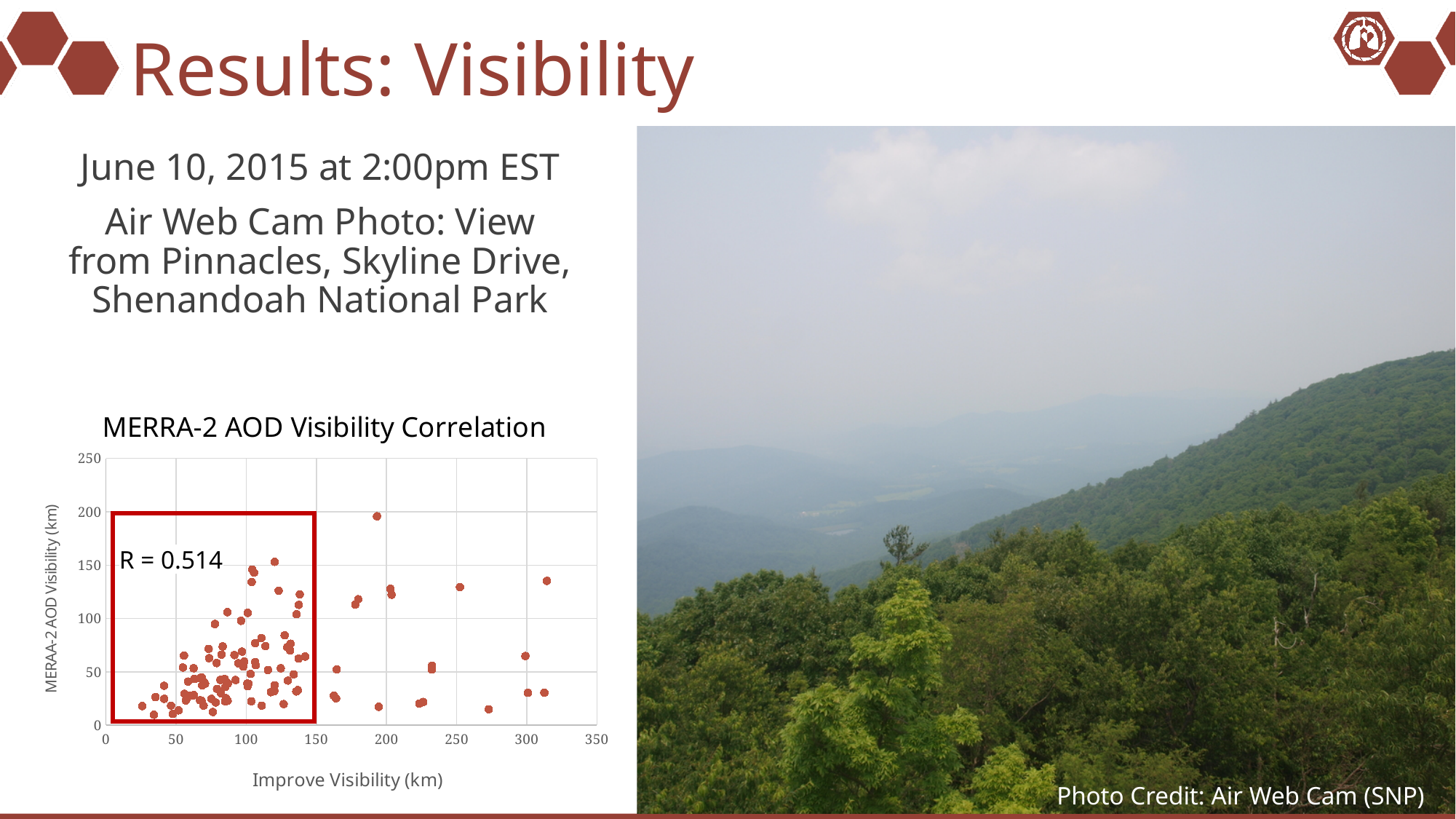
Is the largest Improve Visibility value of any plotted point greater or less than 350? less Is the lowest plotted MERRA-2 AOD Visibility value greater or less than 50? less What is the title of the chart on the slide? MERRA-2 AOD Visibility Correlation What type of chart is shown on the slide? scatter chart Is the highest plotted MERRA-2 AOD Visibility value greater or less than 250? less What correlation coefficient R is printed on the chart? R = 0.514 What is the label of the x axis of the chart? Improve Visibility (km)